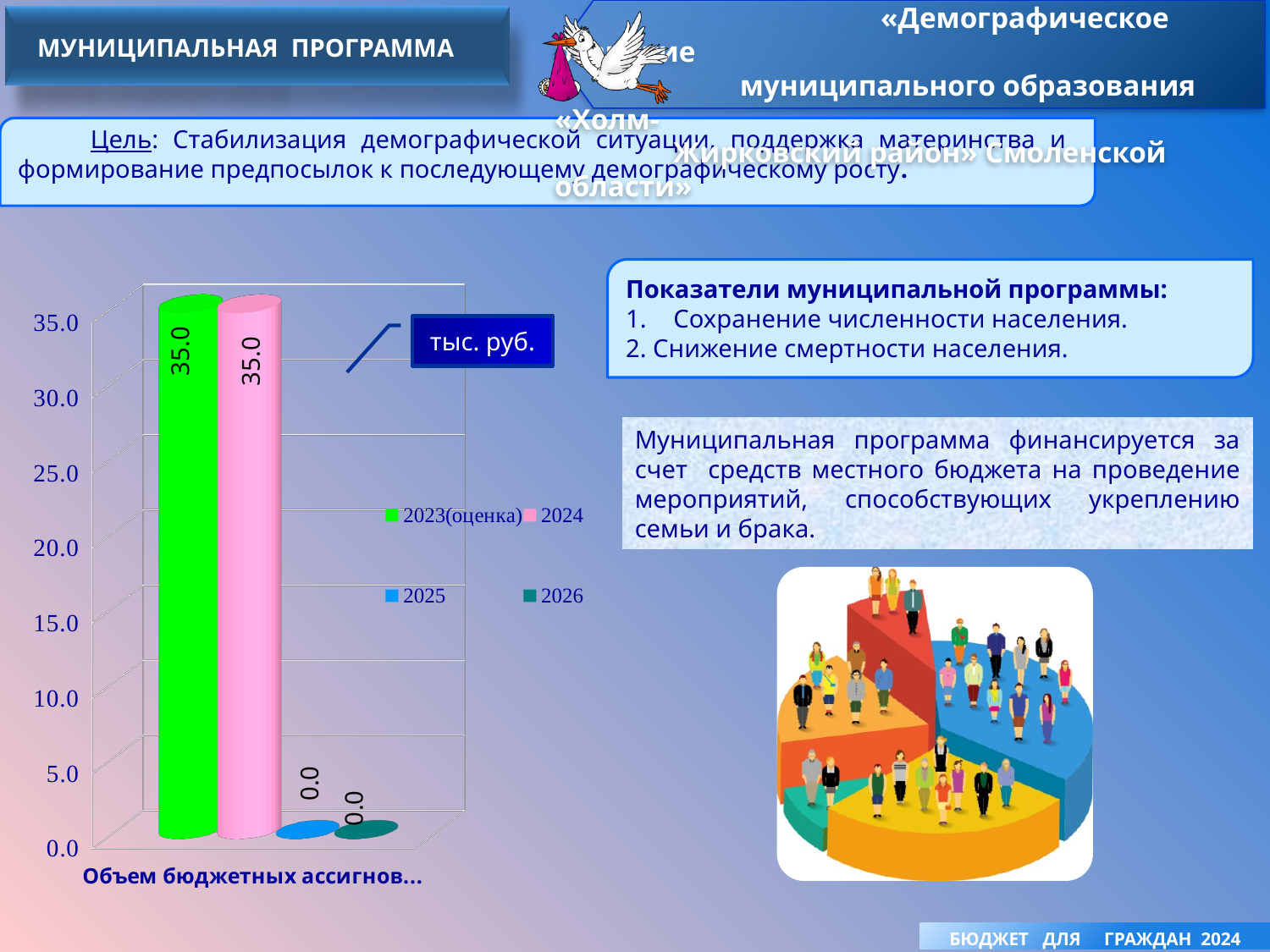
How many series does the chart legend list? 4 What unit is shown in the label box next to the chart? тыс. руб. What kind of chart is shown on the slide? bar chart Which is larger, the value for 2024 or the value for 2026? 2024 What is the value for the 2025 series in the chart? 0.0 What is the value for the 2026 series in the chart? 0.0 What is the value for the 2023(оценка) series in the chart? 35.0 Is the value for 2024 greater or less than 30.0? greater What is the value for the 2024 series in the chart? 35.0 What colour is the bar for the 2023(оценка) series? green What is the difference between the value for 2023(оценка) and the value for 2025? 35.0 What is the highest value shown on the chart's vertical axis? 35.0